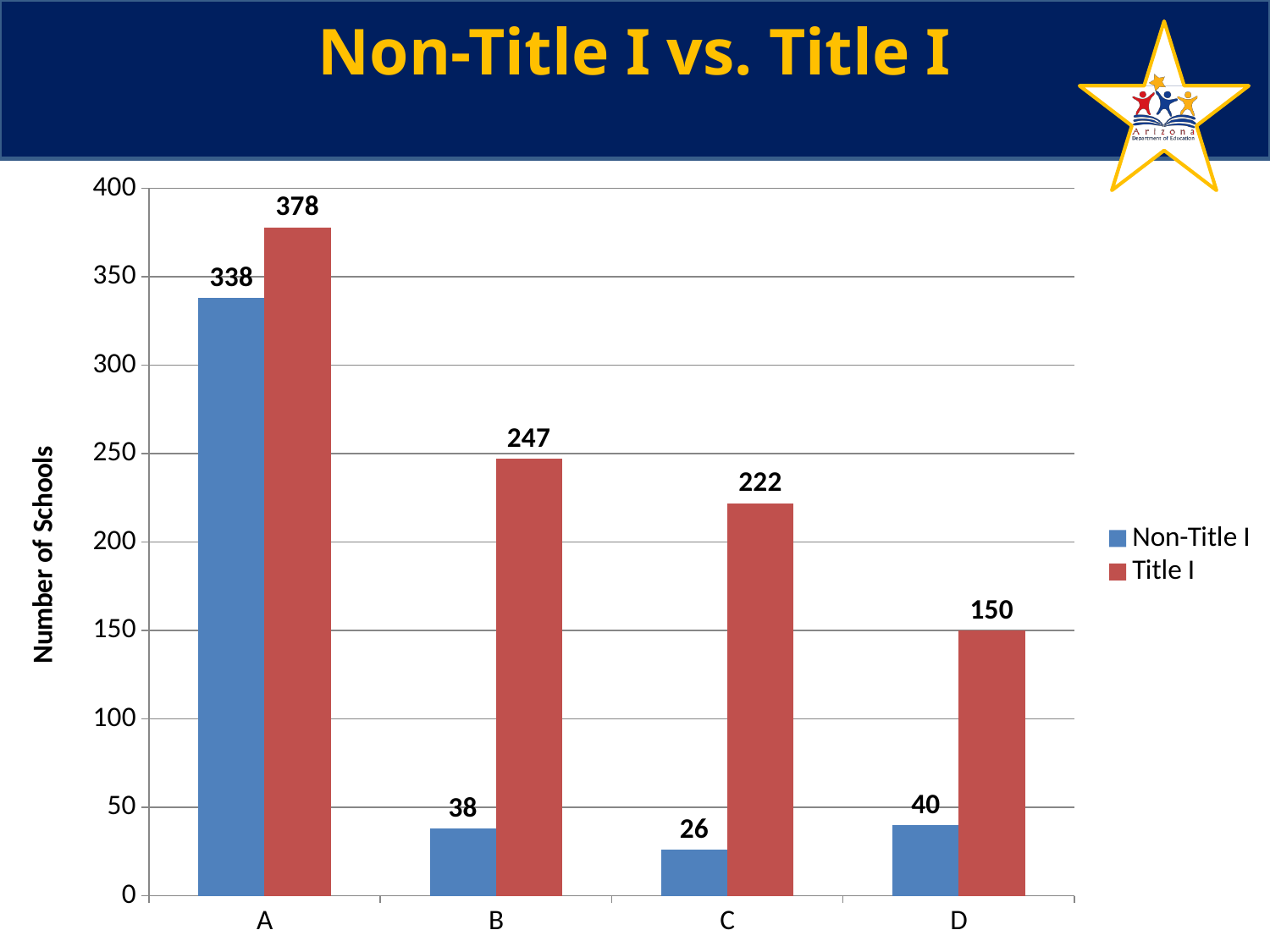
Which is larger for category D: Title I or Non-Title I? Title I What kind of chart is shown on the slide? Bar chart How many categories are shown on the x axis? 4 What is the number of Title I schools for category C? 222 What is the label of the y axis? Number of Schools Do the Title I values rise or fall from category A to category D? Fall What is the number of Non-Title I schools for category A? 338 Which category has the lowest number of Non-Title I schools? C How many series does the legend list? 2 What is the difference between Title I and Non-Title I schools for category B? 209 Which category has the highest number of Title I schools? A What is the number of Non-Title I schools for category D? 40